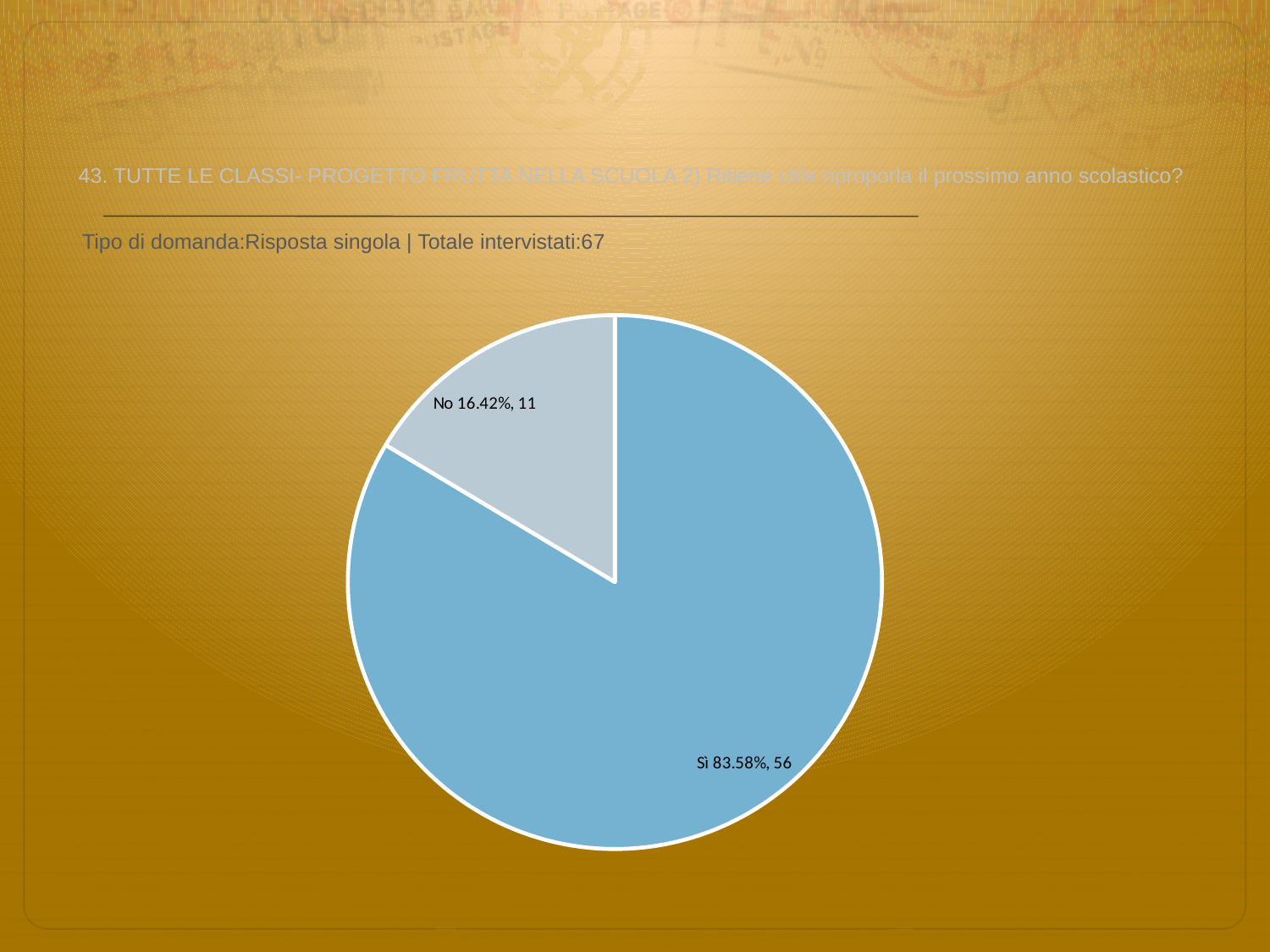
How many slices does the pie chart have? 2 How many respondents answered "No"? 11 Which slice is the largest in the pie chart? Sì What is the total number of respondents shown on the slide? 67 How many respondents answered "Sì"? 56 Which has more responses, "Sì" or "No"? Sì What colour is the "Sì" slice of the pie chart? blue What is the difference between the number of "Sì" and "No" responses? 45 What percentage of the pie does the "Sì" slice represent? 83.58% What kind of chart is shown on the slide? pie chart What percentage of the pie does the "No" slice represent? 16.42% Which slice is the smallest in the pie chart? No